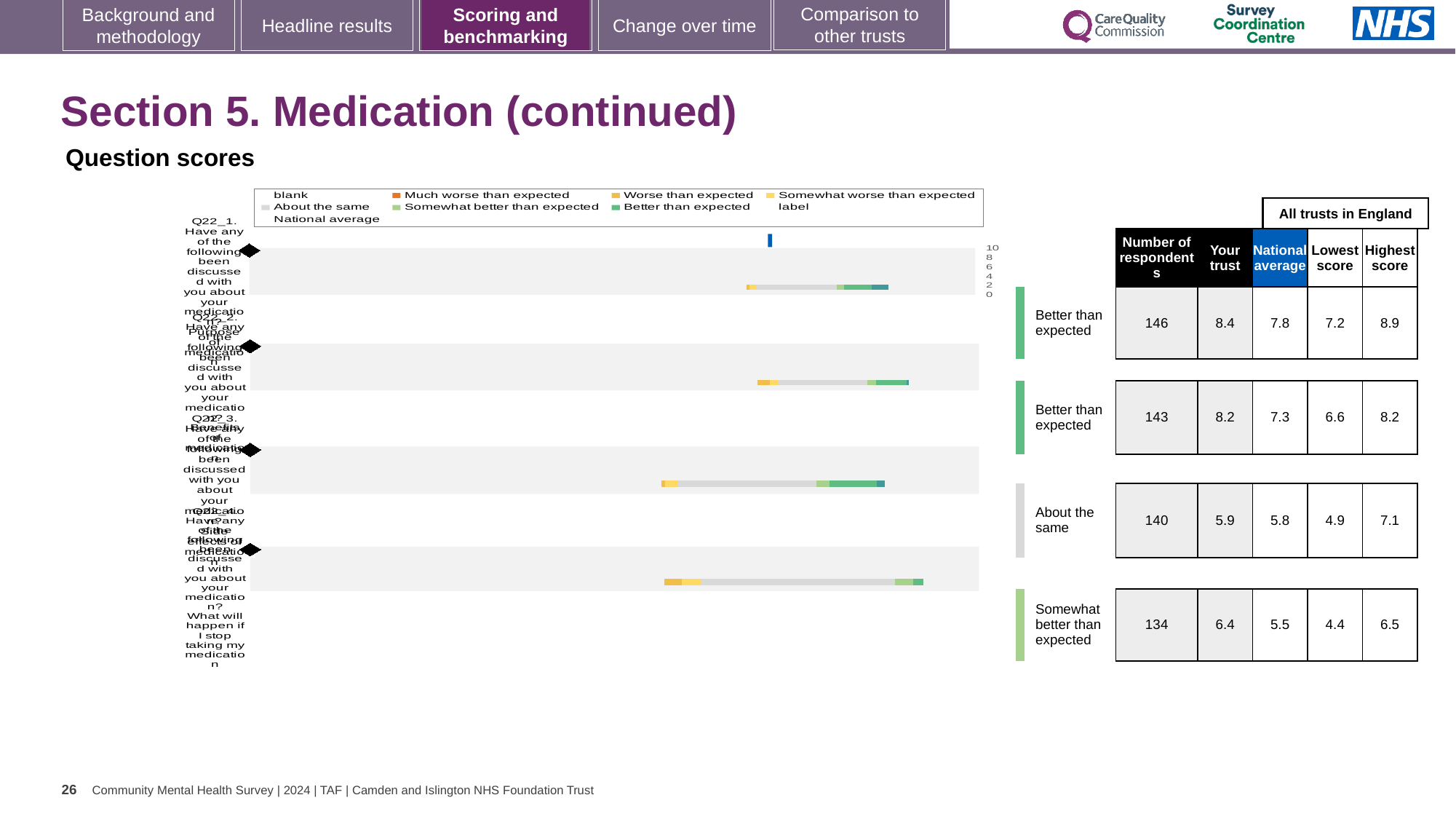
What benchmark category is shown for the third question row? About the same How many question rows (bars) are plotted in the question scores chart? 4 Which question row has the highest 'Your trust' score in the table beside the chart? the first row (8.4) What is the heading above the Lowest score and Highest score columns in the table? All trusts in England In the table beside the chart, what is the number of respondents for the first question row? 146 In the table beside the chart, what is the highest score for the fourth question row? 6.5 Which question row has the lowest number of respondents in the table beside the chart? the fourth row (134) In the table beside the chart, what is the national average for the third question row? 5.8 In the table beside the chart, what is the 'Your trust' score for the second question row? 8.2 What kind of chart is used to show the question scores on this slide? bar chart Is the 'Your trust' score for the first question row larger than its national average? Yes, 8.4 vs 7.8 What is the difference between the 'Your trust' score and the national average for the fourth question row? 0.9